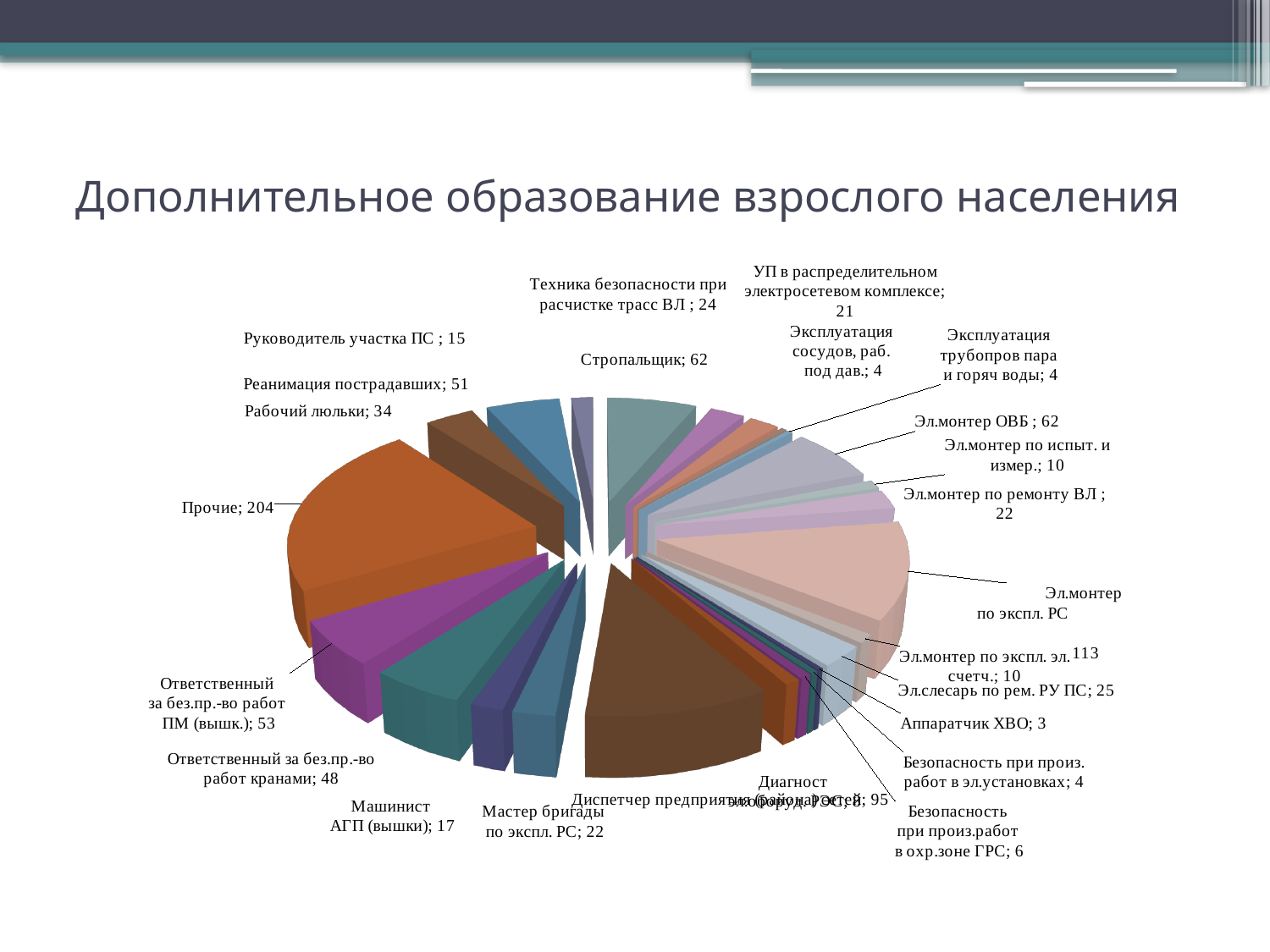
Which is larger, the value for Ответственный за без.пр.-во работ ПМ (вышк.) or the value for Ответственный за без.пр.-во работ кранами? Ответственный за без.пр.-во работ ПМ (вышк.) What is the value for Реанимация пострадавших? 51 What is the difference between the values for Прочие and Эл.монтер по экспл. РС? 91 Which category has the largest value? Прочие Which category has the smallest value? Аппаратчик ХВО What is the value for Стропальщик? 62 What kind of chart is shown on the slide? pie chart What is the difference between the values for Рабочий люльки and Машинист АГП (вышки)? 17 What is the title of the slide? Дополнительное образование взрослого населения What is the value for Эл.монтер по экспл. РС? 113 What is the value for Прочие? 204